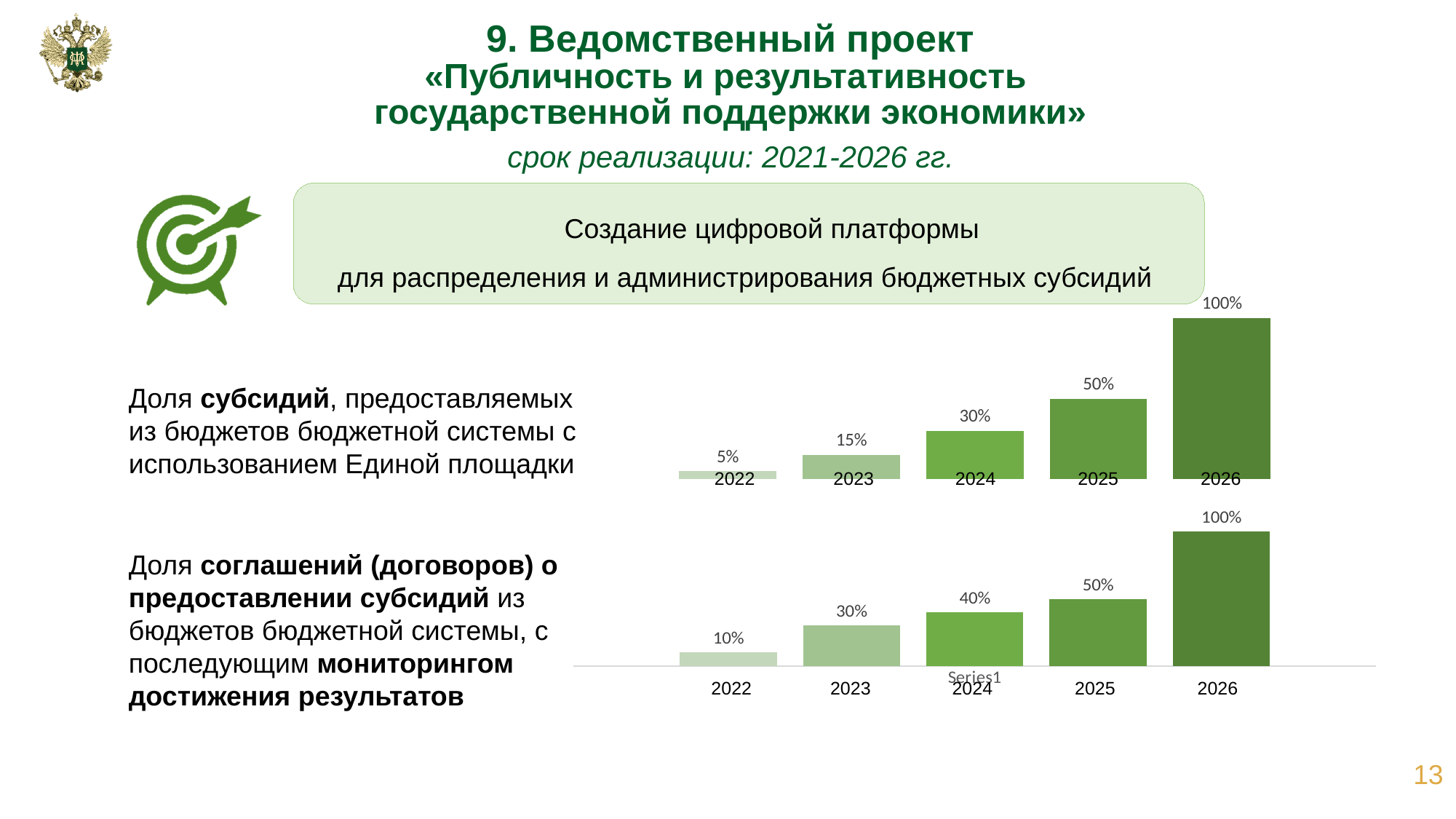
In the top chart, do the values rise or fall from 2022 to 2026? Rise In the top chart, what is the difference between the values for 2026 and 2025? 50% What type of chart is the bottom chart? Bar chart In the top chart, what is the value for 2023? 15% In the top chart, which year has the lowest value? 2022 How many years are shown in the top chart? 5 In the bottom chart, what is the difference between the values for 2023 and 2022? 20% In the top chart, what is the value for 2025? 50% In the bottom chart, what is the value for 2022? 10% In the bottom chart, which year has the highest value? 2026 In the bottom chart, what is the value for 2024? 40% Which is larger: the value for 2023 in the top chart or the value for 2023 in the bottom chart? The bottom chart (30%)